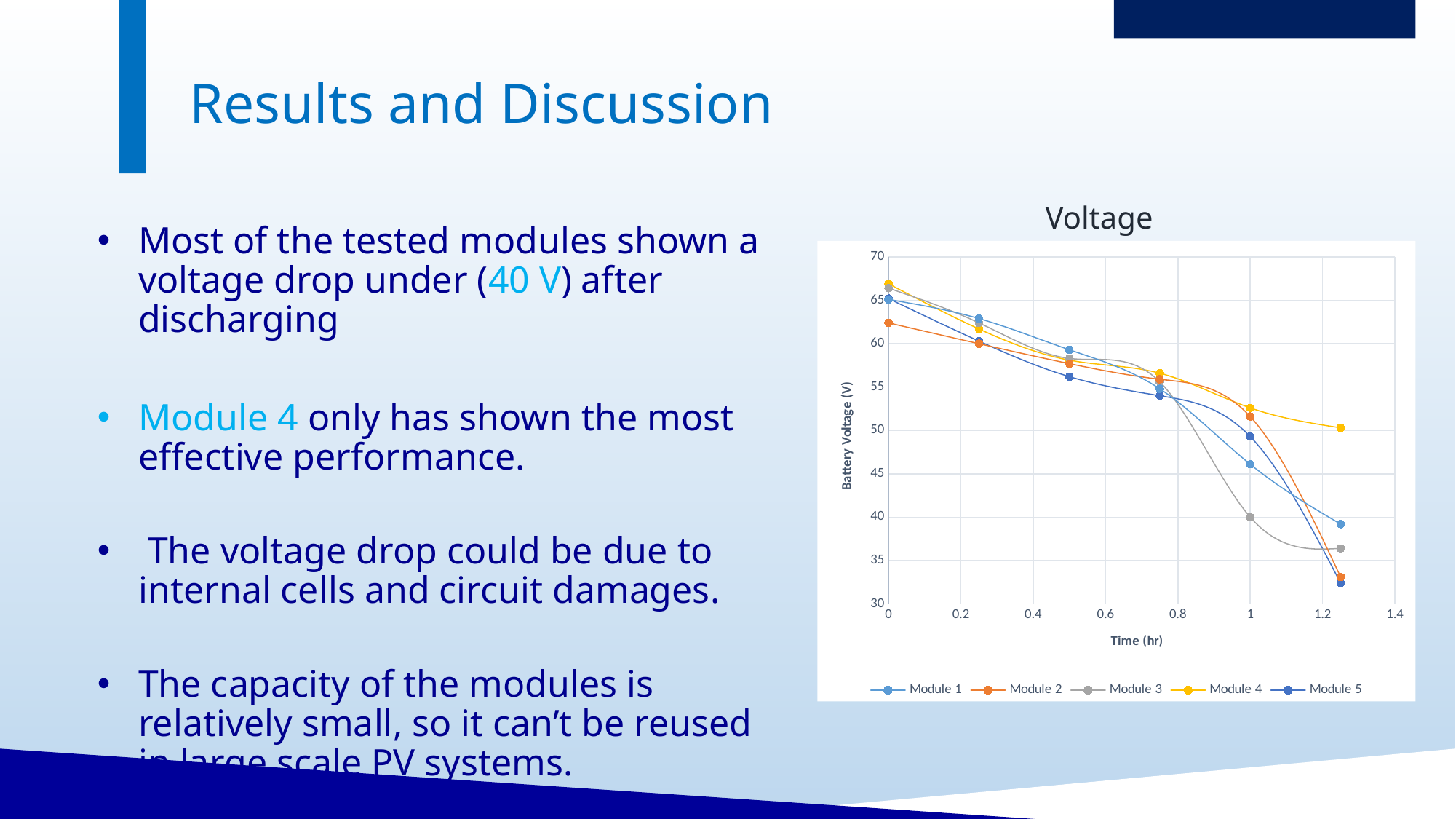
What is the title of the chart? Voltage Is the battery voltage of Module 5 at the last time point greater or less than 35? less Do the battery voltage values rise or fall as time increases? fall At the last time point, is the battery voltage of Module 1 or Module 3 larger? Module 1 Which module has the highest battery voltage at 1.2 hours (the last time point)? Module 4 How many data points are plotted for each module in the Voltage chart? 6 Is the battery voltage of Module 3 at 1 hour greater or less than 45? less Which module has the lowest battery voltage at 1 hour? Module 3 What is the label of the y axis of the chart? Battery Voltage (V) How many series does the legend of the Voltage chart list? 5 What kind of chart is shown on the slide? line chart Is the battery voltage of Module 4 at the last time point greater or less than 45? greater